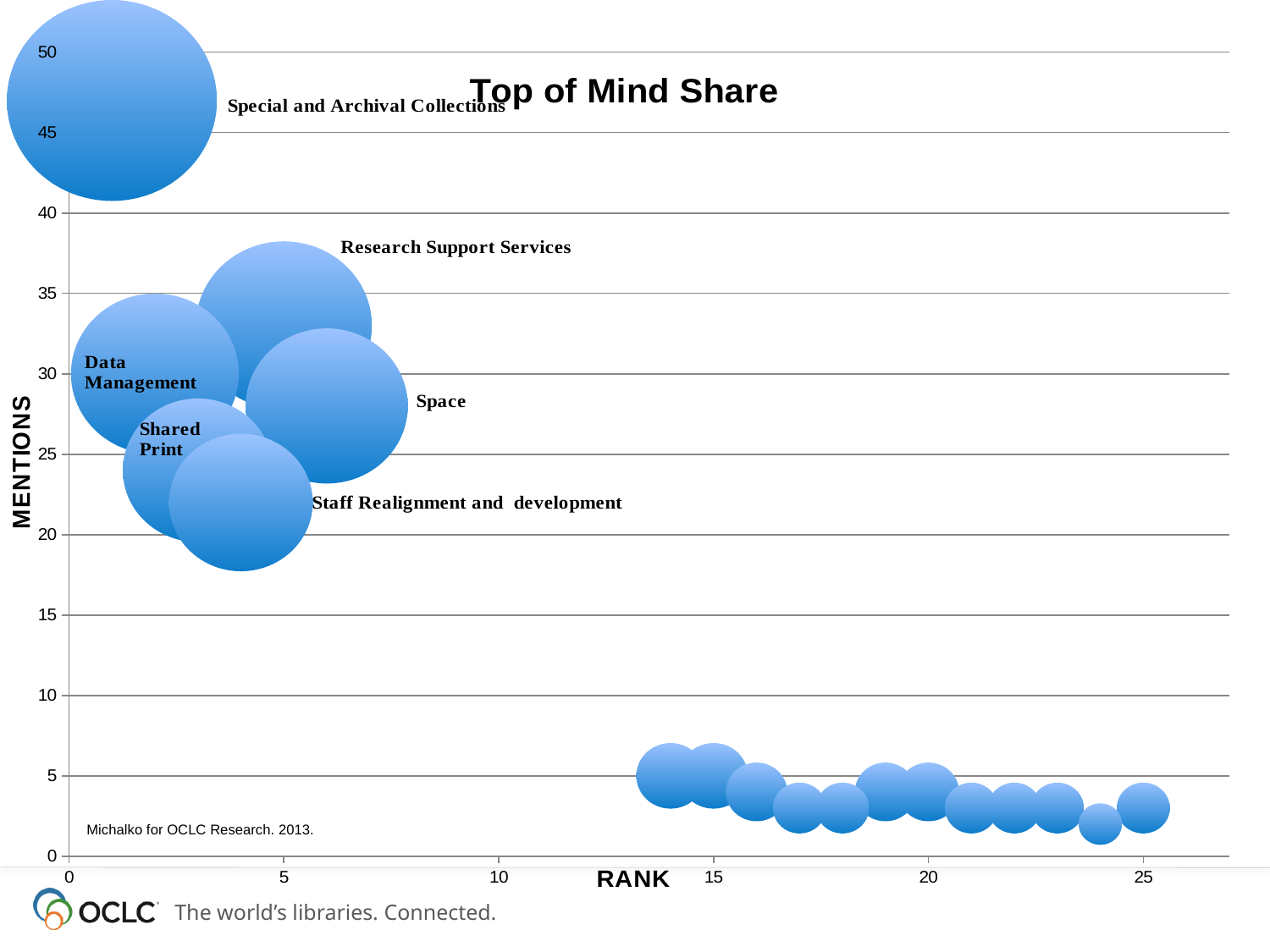
What is the title of the chart? Top of Mind Share Which has more mentions, Research Support Services or Staff Realignment and development? Research Support Services Which has more mentions, Special and Archival Collections or Space? Special and Archival Collections What is the label of the vertical axis? MENTIONS What kind of chart is shown on the slide? bubble chart Is the value for Data Management greater or less than 25? greater Is the value for Space greater or less than 35? less Is the value for Special and Archival Collections greater or less than 45? greater Do mentions rise or fall as rank increases along the x axis? fall Which labeled topic has the highest number of mentions? Special and Archival Collections